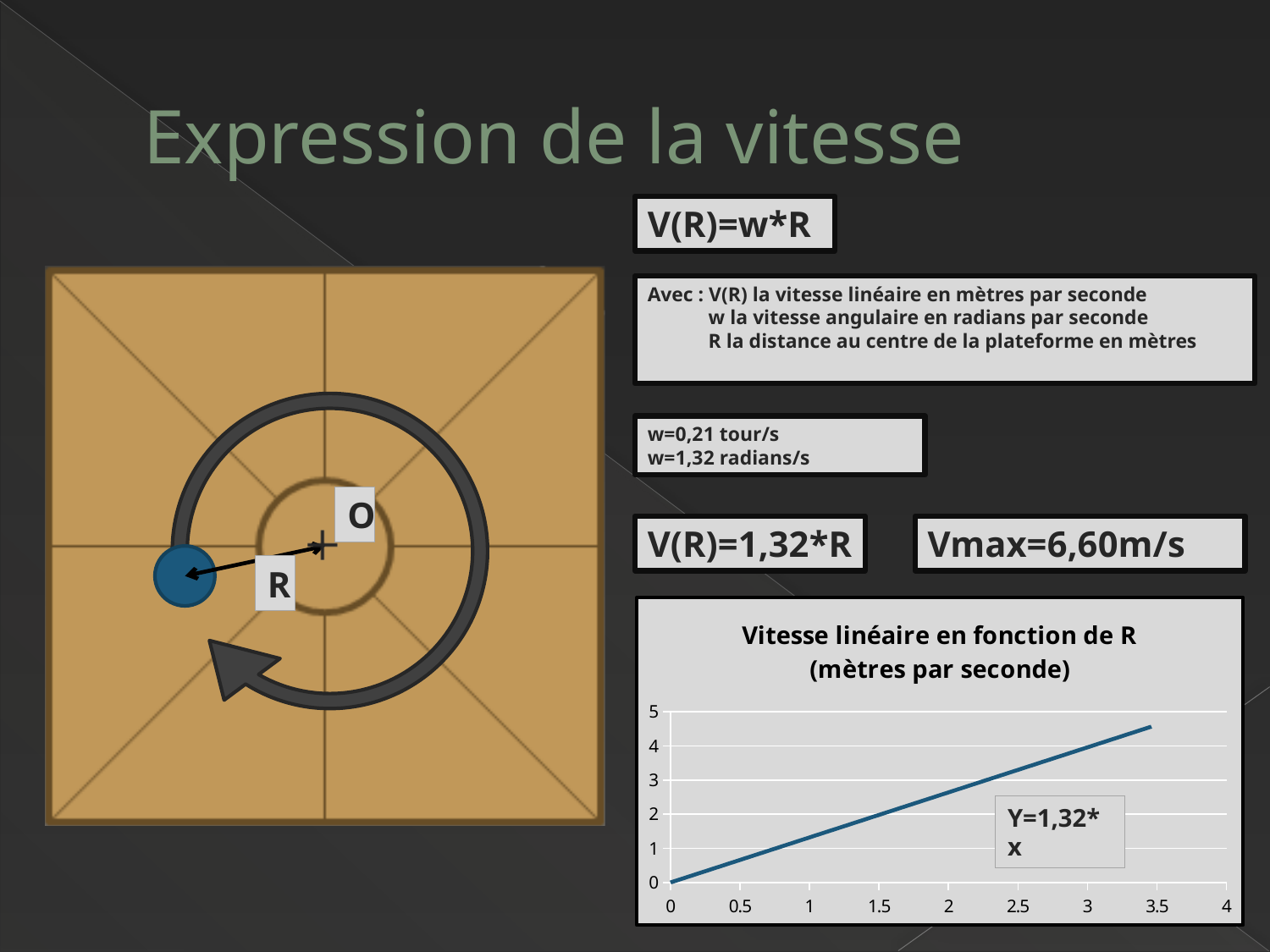
What equation is written on the chart for the plotted line? Y=1,32*x What is the value of the line at R=0? 0 What kind of chart is shown on the slide? line chart Is the value of the line at R=2 greater or less than 3? less Is the value of the line at R=0.5 greater or less than 1? less Is the value of the line at R=3.5 greater or less than 4? greater Does the plotted line rise or fall as R increases along the x axis? rise What is the title of the chart? Vitesse linéaire en fonction de R (mètres par seconde)